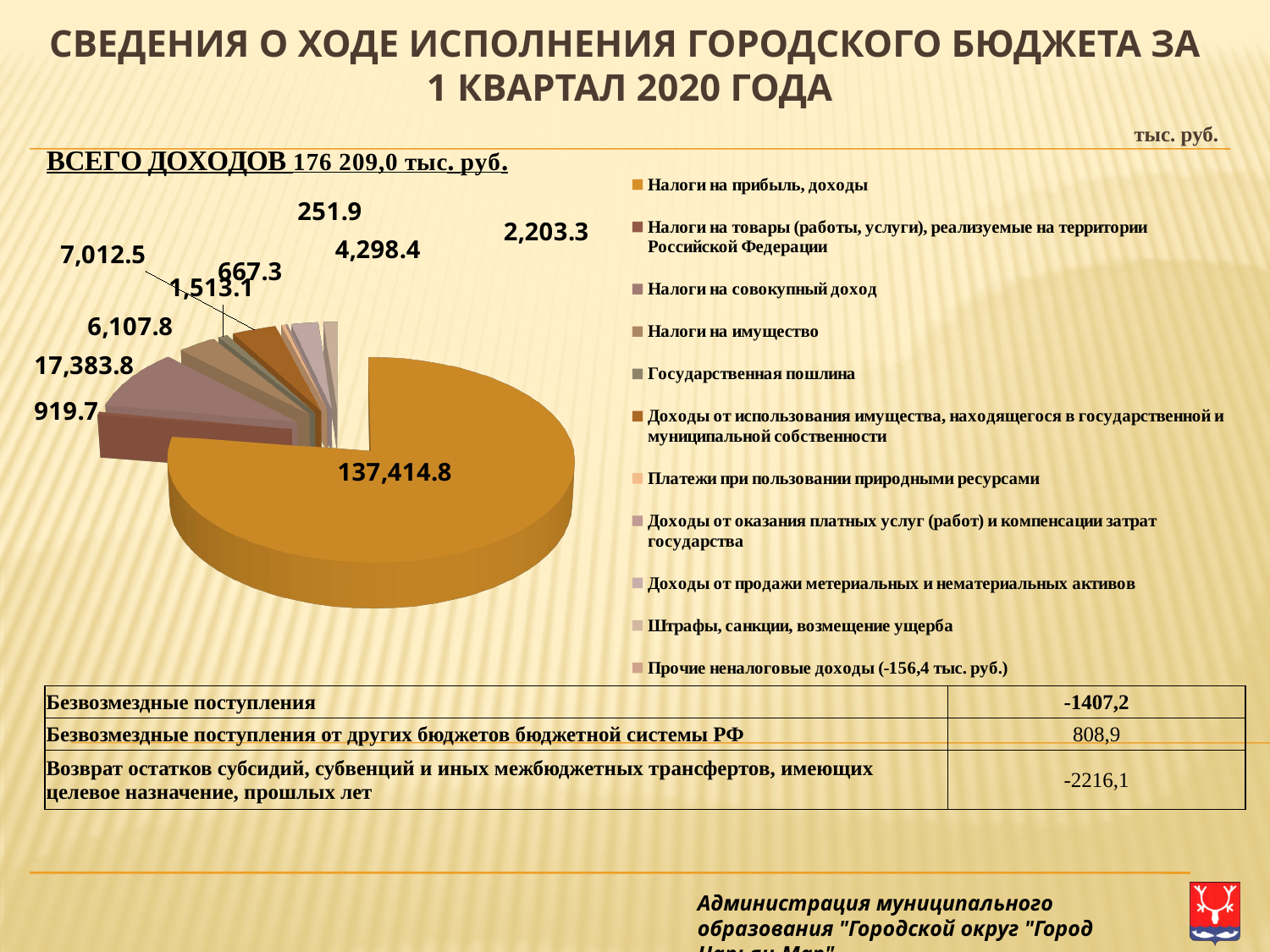
What total income (ВСЕГО ДОХОДОВ) is stated above the chart? 176 209,0 тыс. руб. What type of chart is shown on the slide? pie chart What value is given in the legend for 'Прочие неналоговые доходы'? -156,4 тыс. руб. What unit is indicated for the values on the slide? тыс. руб. How many entries does the chart legend list? 11 Which legend category does the largest slice (137,414.8) correspond to? Налоги на прибыль, доходы How many data labels are printed on the pie chart? 10 What is the smallest data label shown on the pie chart? 251.9 Which is larger among the pie chart labels: 17,383.8 or 7,012.5? 17,383.8 What is the value of the largest slice in the pie chart? 137,414.8 Which is larger among the pie chart labels: 4,298.4 or 2,203.3? 4,298.4 In the table below the chart, what is the value for 'Безвозмездные поступления'? -1407,2